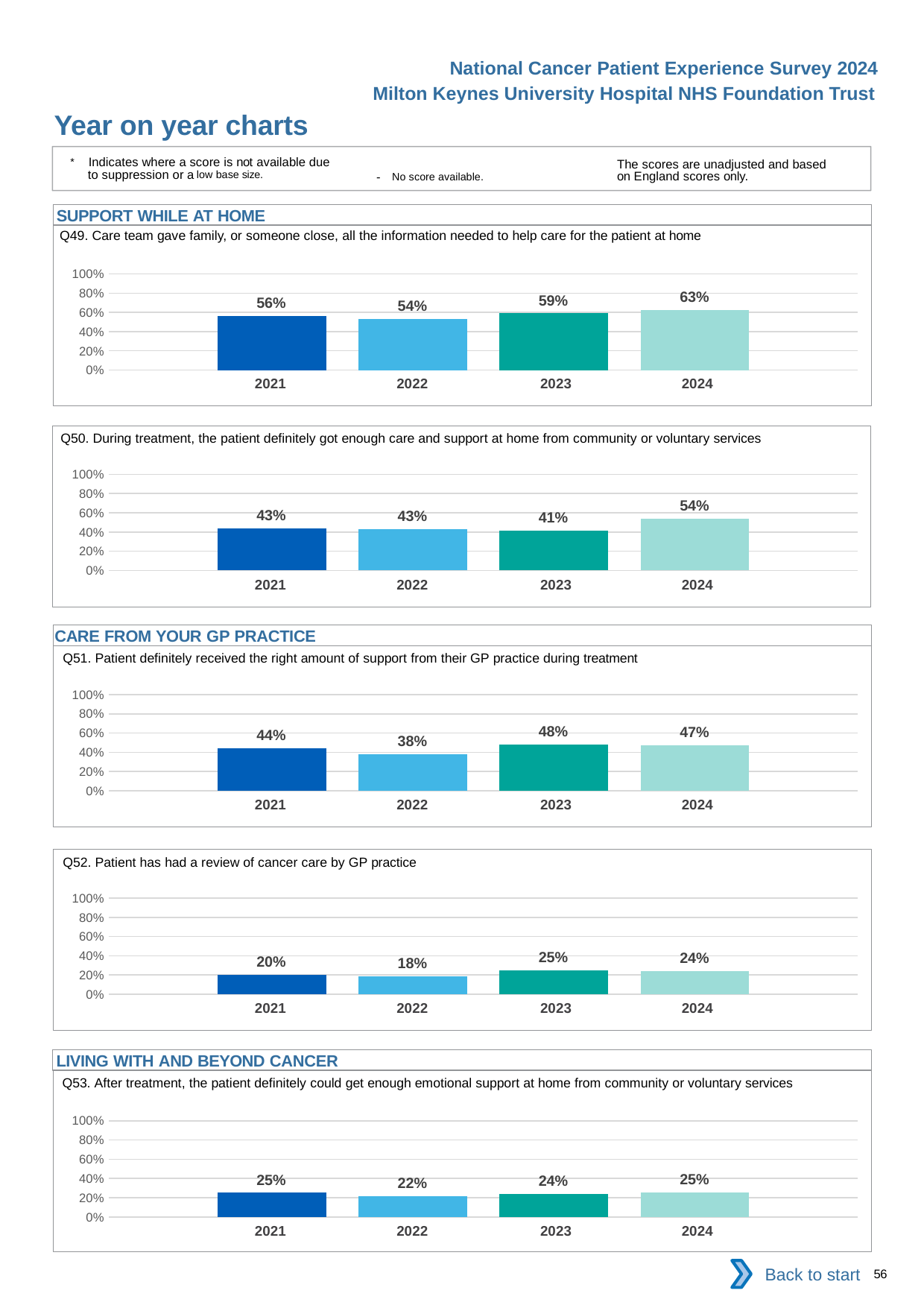
In the Q52 chart, how many years are plotted? 4 In the Q49 chart, is the value for 2024 greater or less than 60%? greater In the Q53 chart, which year has the lowest value? 2022 What type of chart is used for Q52? Bar chart In the Q51 chart, is the value for 2023 larger or smaller than the value for 2021? larger In the Q53 chart, what is the difference between the 2021 and 2022 values? 3 percentage points In the Q49 chart, which year has the lowest value? 2022 In the Q49 chart, what is the value for 2024? 63% In the Q52 chart, what is the value for 2021? 20% In the Q50 chart, which year has the highest value? 2024 In the Q50 chart, what is the difference between the 2024 and 2023 values? 13 percentage points In the Q51 chart, what is the value for 2022? 38%